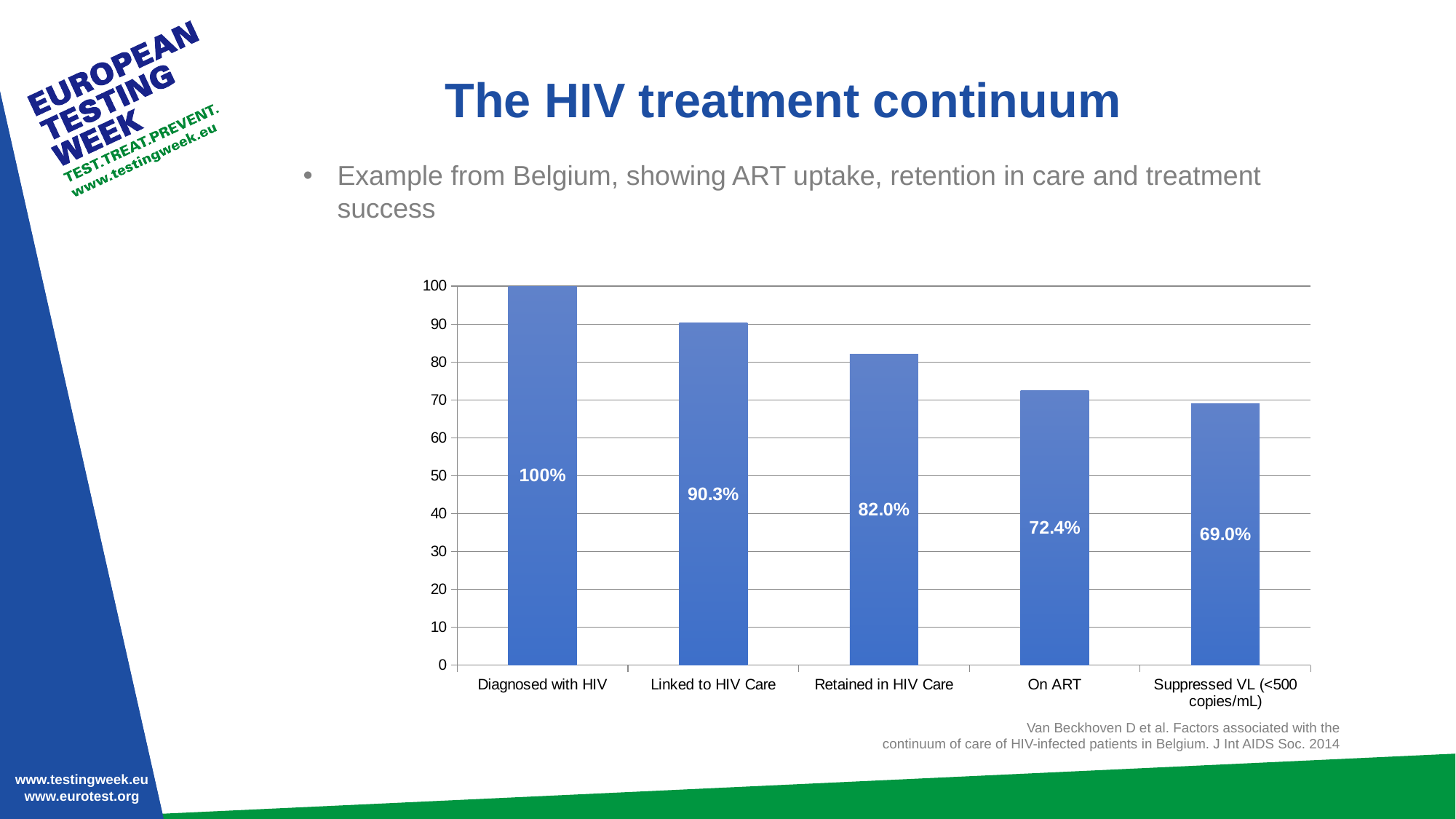
Do the values rise or fall from left to right along the x axis? Fall What is the value for On ART? 72.4% What is the value for Suppressed VL (<500 copies/mL)? 69.0% Which is larger, the value for On ART or the value for Suppressed VL (<500 copies/mL)? On ART What is the value for Linked to HIV Care? 90.3% What is the value for Retained in HIV Care? 82.0% What is the difference between the values for Linked to HIV Care and Retained in HIV Care? 8.3% Which category has the lowest value? Suppressed VL (<500 copies/mL) Which category has the highest value? Diagnosed with HIV Is the value for On ART greater or less than 80? less How many categories are shown on the x axis? 5 What kind of chart is shown on the slide? Bar chart